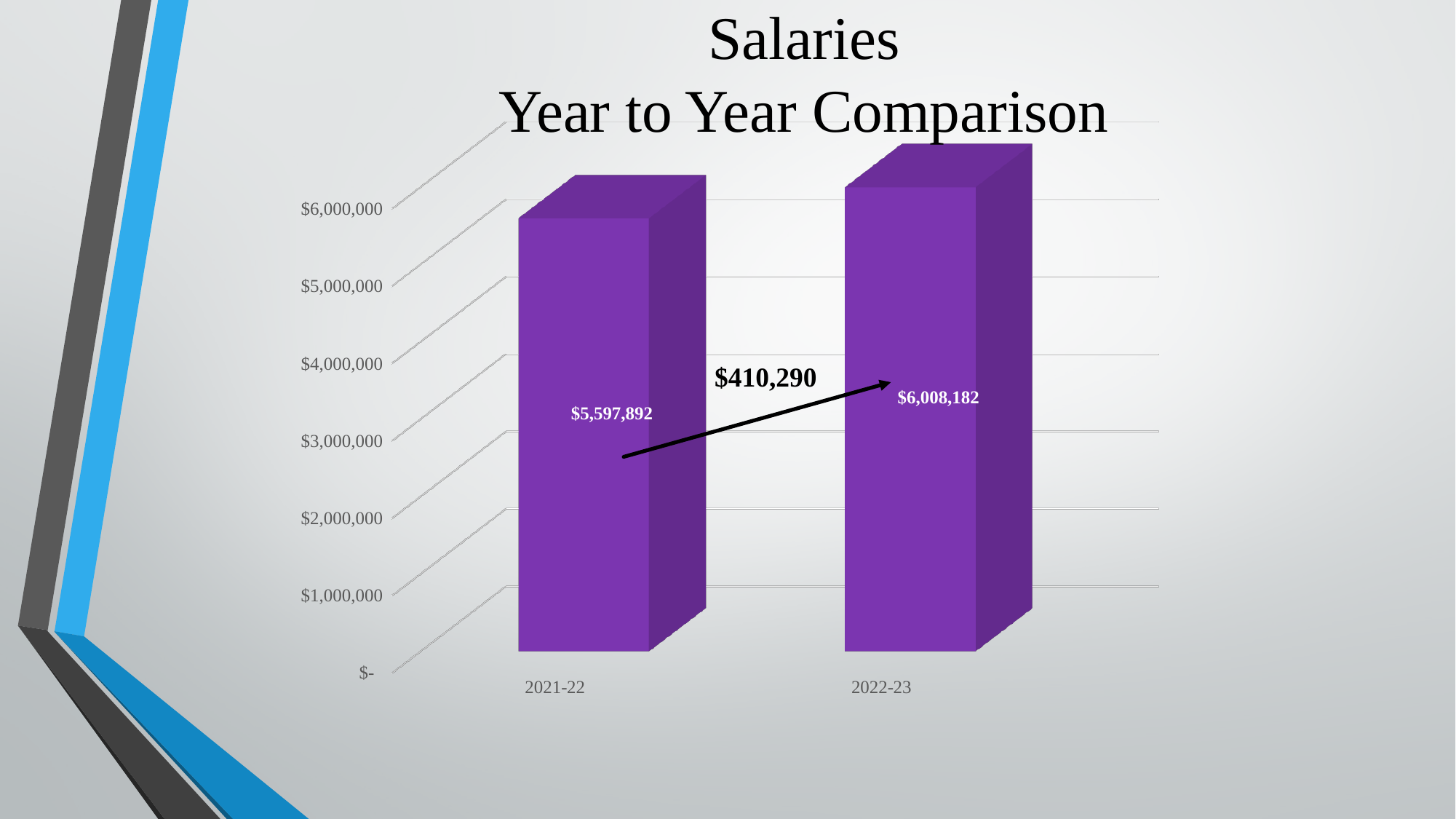
Is the value for 2021-22 greater or less than $6,000,000? less Is the salary value for 2022-23 larger than the value for 2021-22? Yes What is the difference between the 2022-23 and 2021-22 salary values? $410,290 Which year has the higher salary value? 2022-23 What kind of chart is shown on the slide? Bar chart How many years are shown on the chart? 2 Is the value for 2022-23 greater or less than $6,000,000? greater Do the salary values rise or fall from 2021-22 to 2022-23? Rise What is the title of the chart? Salaries Year to Year Comparison What is the salary value for 2022-23? $6,008,182 What is the salary value for 2021-22? $5,597,892 Which year has the lower salary value? 2021-22